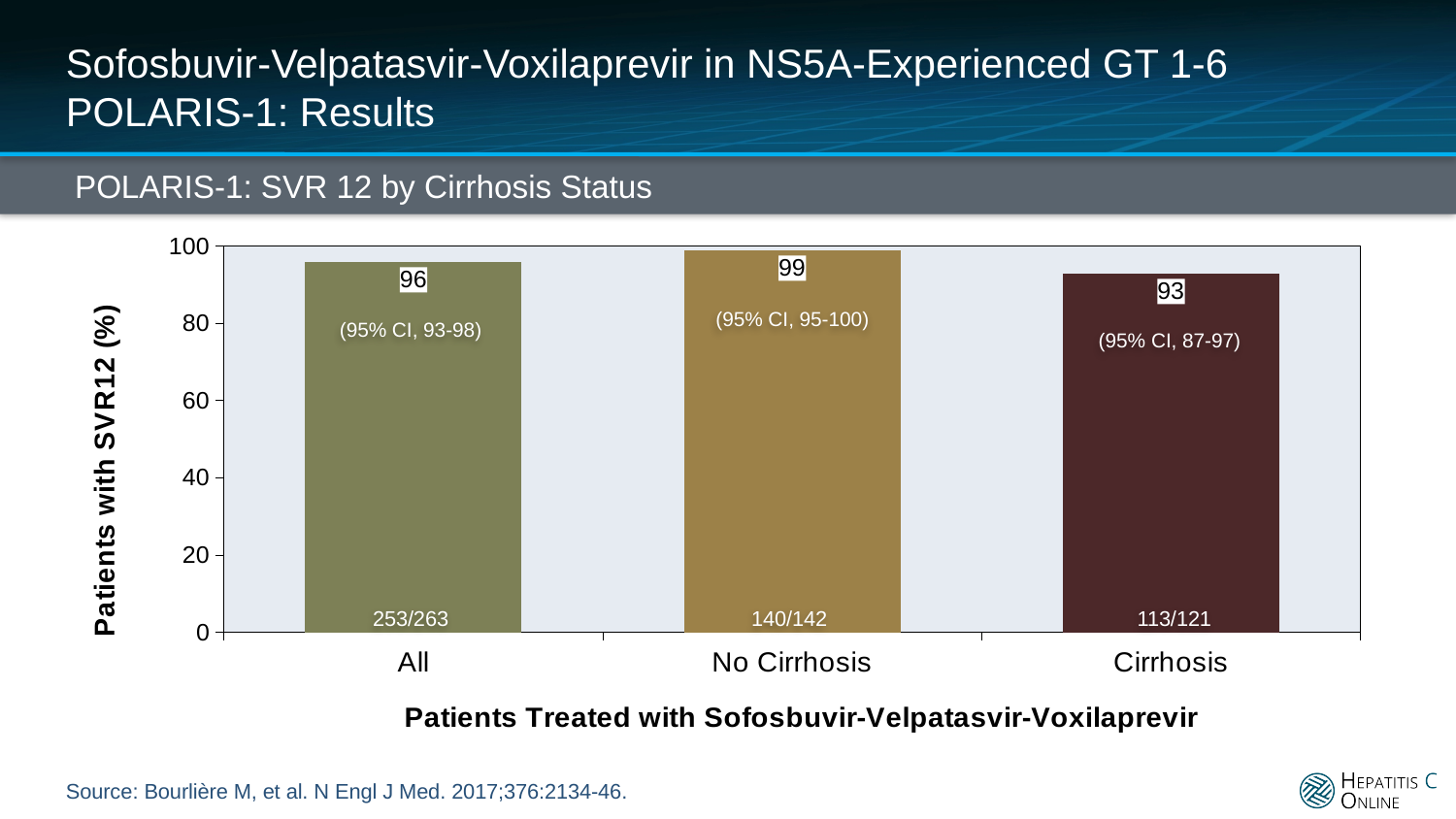
What is the SVR12 rate for patients with Cirrhosis? 93 Which group has a higher SVR12 rate, All or Cirrhosis? All How many patient groups are shown on the chart? 3 What is the SVR12 rate for the All group? 96 Which group has the highest SVR12 rate? No Cirrhosis What is the title of the chart? POLARIS-1: SVR 12 by Cirrhosis Status What is the SVR12 rate for patients with No Cirrhosis? 99 What fraction of patients is shown for the No Cirrhosis group? 140/142 Which group has the lowest SVR12 rate? Cirrhosis What is the 95% confidence interval shown for the Cirrhosis group? 87-97 What is the difference in SVR12 rate between the No Cirrhosis and Cirrhosis groups? 6 What kind of chart is shown on the slide? Bar chart